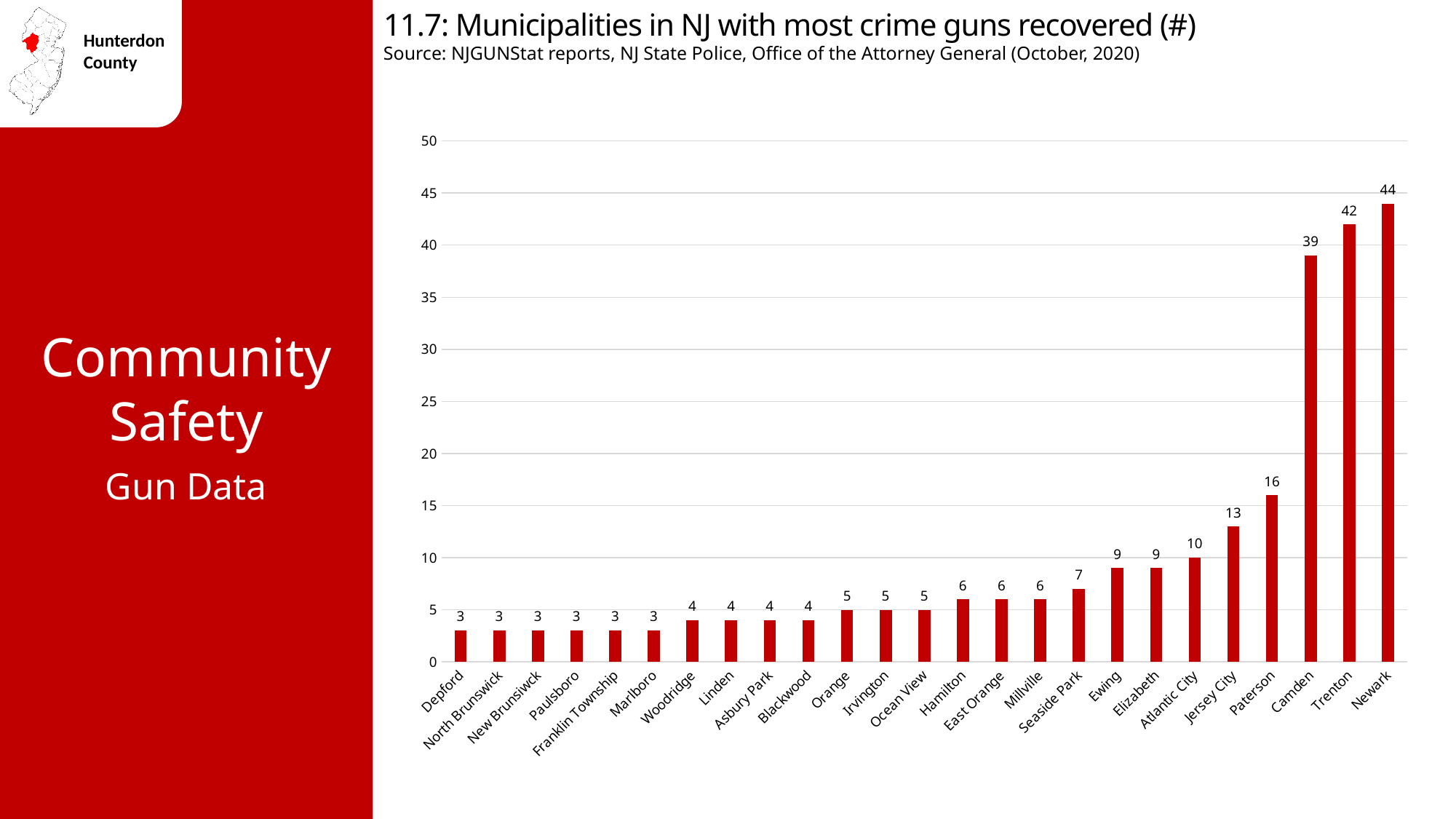
What is the number of crime guns recovered in Camden? 39 What kind of chart is shown on the slide? Bar chart Which municipality has the highest number of crime guns recovered? Newark Is the value for Trenton greater or less than 40? greater Which has a larger value, Ewing or Seaside Park? Ewing How many municipalities are shown in the chart? 25 What is the difference between the values for Newark and Trenton? 2 What is the difference between the values for Camden and Jersey City? 26 What is the number of crime guns recovered in Newark? 44 What is the number of crime guns recovered in Atlantic City? 10 Do the values rise or fall moving from left to right along the x axis? Rise What is the number of crime guns recovered in Paterson? 16